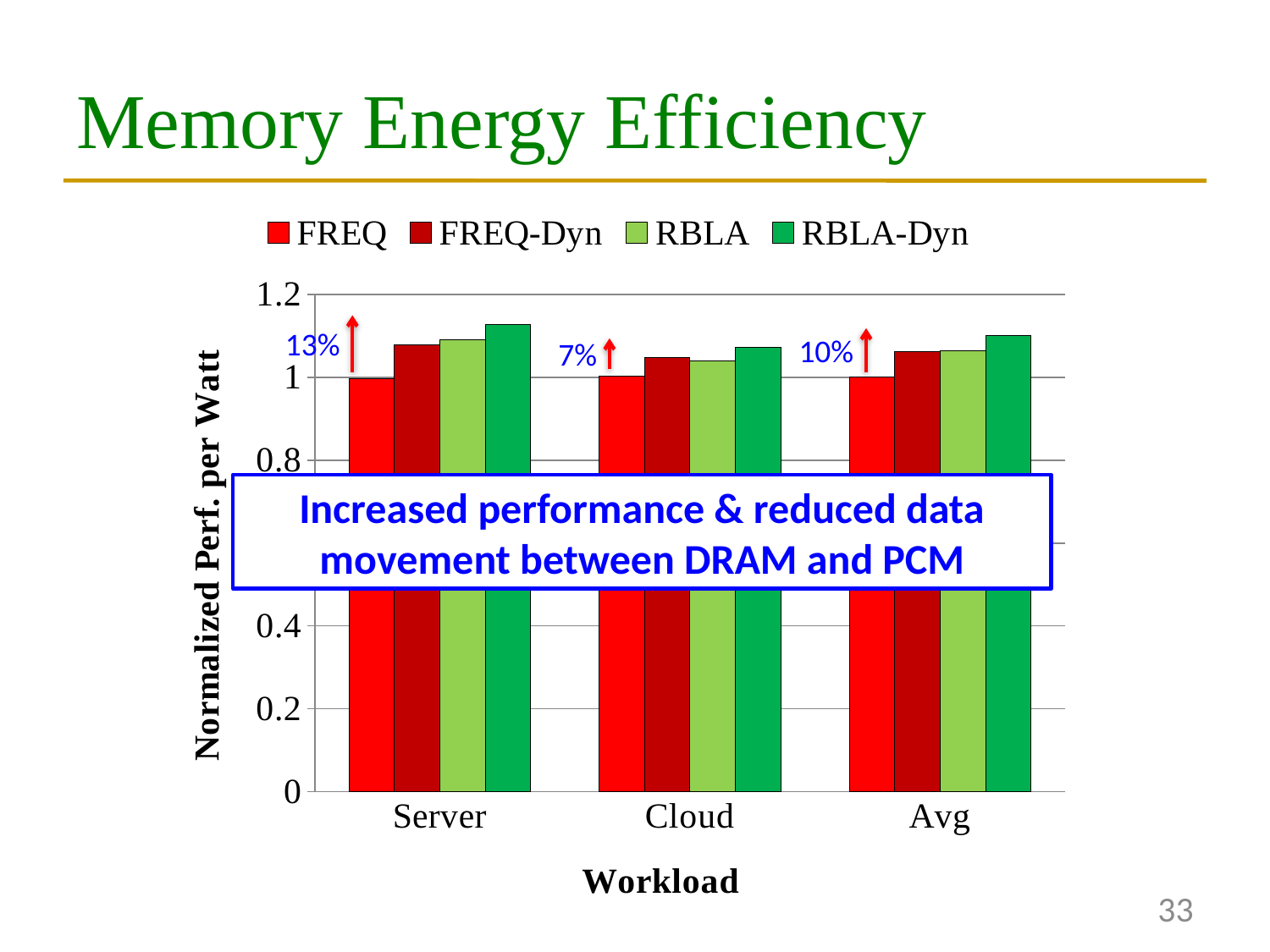
How many series does the legend list? 4 What percentage improvement is annotated above the Server workload? 13% How many workload categories are shown on the x axis? 3 Is the value for RBLA-Dyn on the Server workload greater or less than 1? greater What percentage improvement is annotated above the Avg workload? 10% What is the title of the y axis? Normalized Perf. per Watt Which series has the lowest bar for the Server workload? FREQ Which is larger: the RBLA-Dyn bar for Server or the RBLA-Dyn bar for Cloud? Server Which series has the highest bar for the Server workload? RBLA-Dyn What percentage improvement is annotated above the Cloud workload? 7% What kind of chart is shown on the slide? bar chart